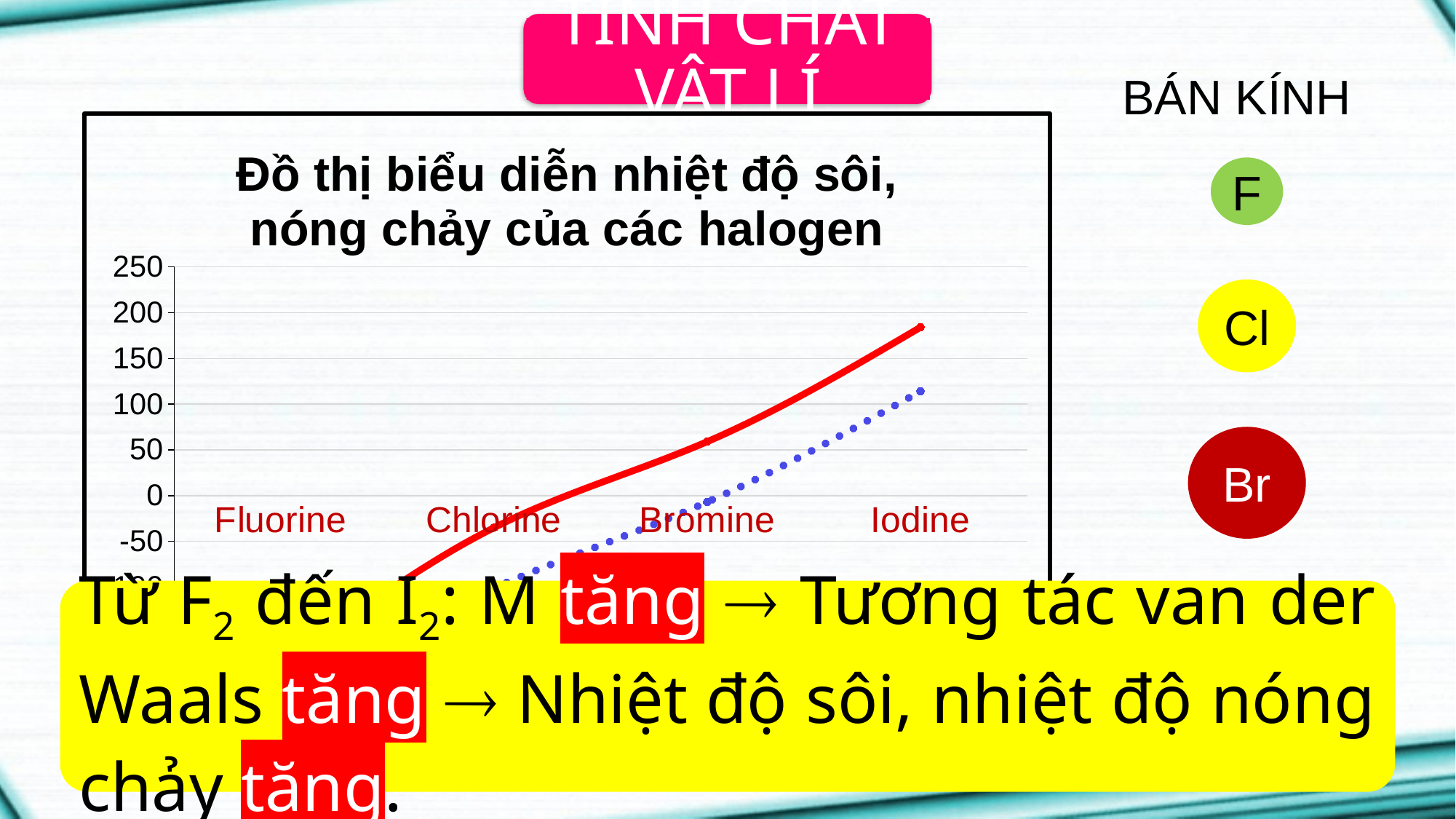
What kind of chart is shown on the slide? line chart Is the value of the solid red line for Iodine greater or less than 150? greater For which category does the solid red line reach its highest value? Iodine Which categories are listed along the x axis of the chart? Fluorine, Chlorine, Bromine, Iodine Do the values of the solid red line rise or fall from Fluorine to Iodine? rise For which category does the solid red line have its lowest value? Fluorine Is the value of the solid red line for Chlorine greater or less than 0? less How many lines are plotted on the chart? 2 What is the title of the chart? Đồ thị biểu diễn nhiệt độ sôi, nóng chảy của các halogen Do the values of the dotted blue line rise or fall from Fluorine to Iodine? rise At Iodine, which line has the larger value, the solid red line or the dotted blue line? the solid red line How many categories are shown on the x axis of the chart? 4